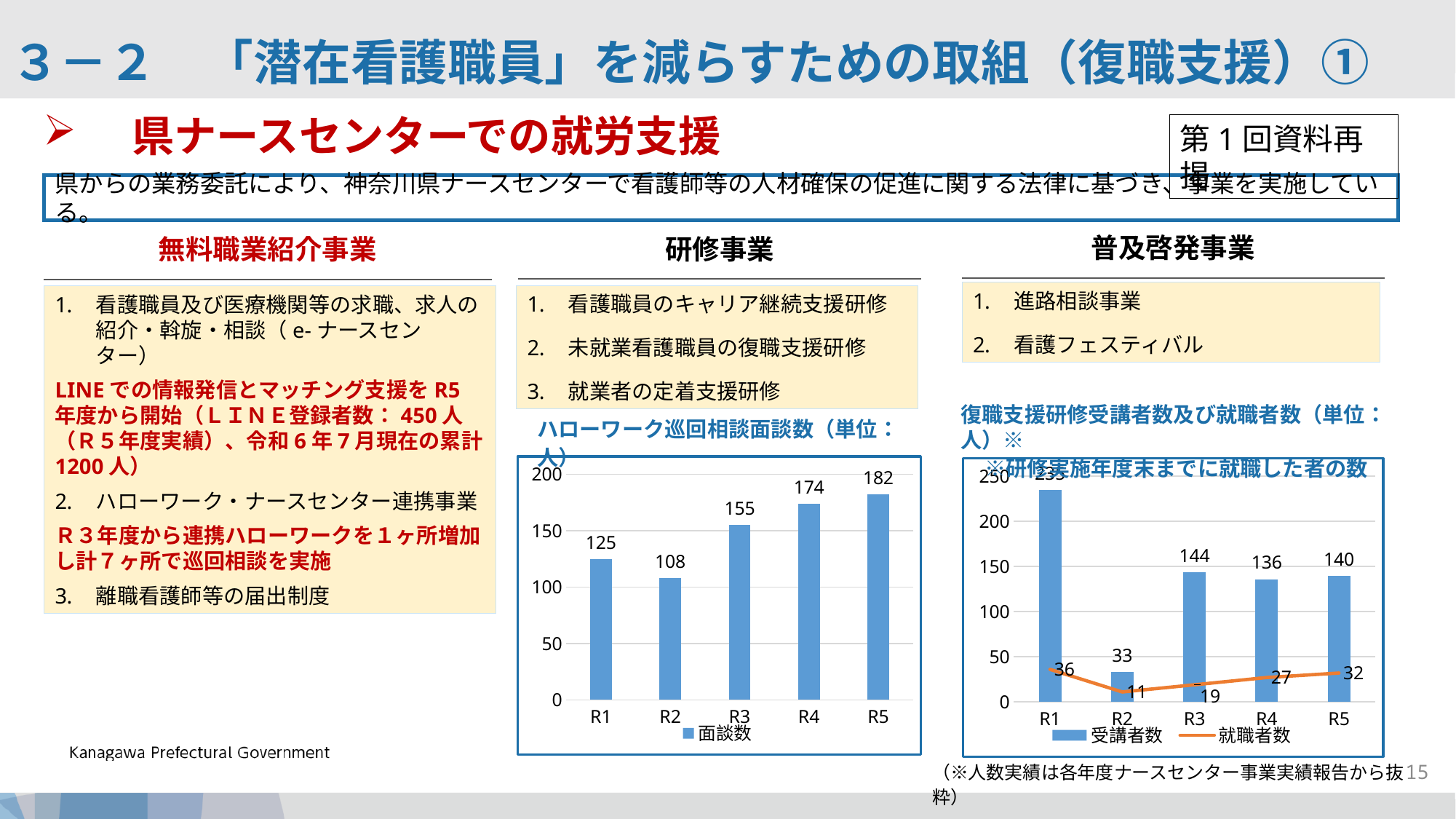
In the ハローワーク巡回相談面談数 chart, which year has the lowest value? R2 What kind of chart is the ハローワーク巡回相談面談数 chart? bar chart In the 復職支援研修受講者数及び就職者数 chart, what is the 就職者数 value for R2? 11 In the 復職支援研修受講者数及び就職者数 chart, what is the 受講者数 value for R3? 144 In the ハローワーク巡回相談面談数 chart, what is the difference between the R5 and R1 values? 57 In the ハローワーク巡回相談面談数 chart, which year has the highest value? R5 In the ハローワーク巡回相談面談数 chart, how many years are shown on the x axis? 5 In the ハローワーク巡回相談面談数 chart, what is the value for R3? 155 In the 復職支援研修受講者数及び就職者数 chart, how many series does the legend list? 2 In the 復職支援研修受講者数及び就職者数 chart, is the 就職者数 value for R4 larger or smaller than the value for R5? smaller In the 復職支援研修受講者数及び就職者数 chart, which year has the highest 受講者数? R1 In the 復職支援研修受講者数及び就職者数 chart, what is the difference between the 受講者数 and 就職者数 values for R5? 108